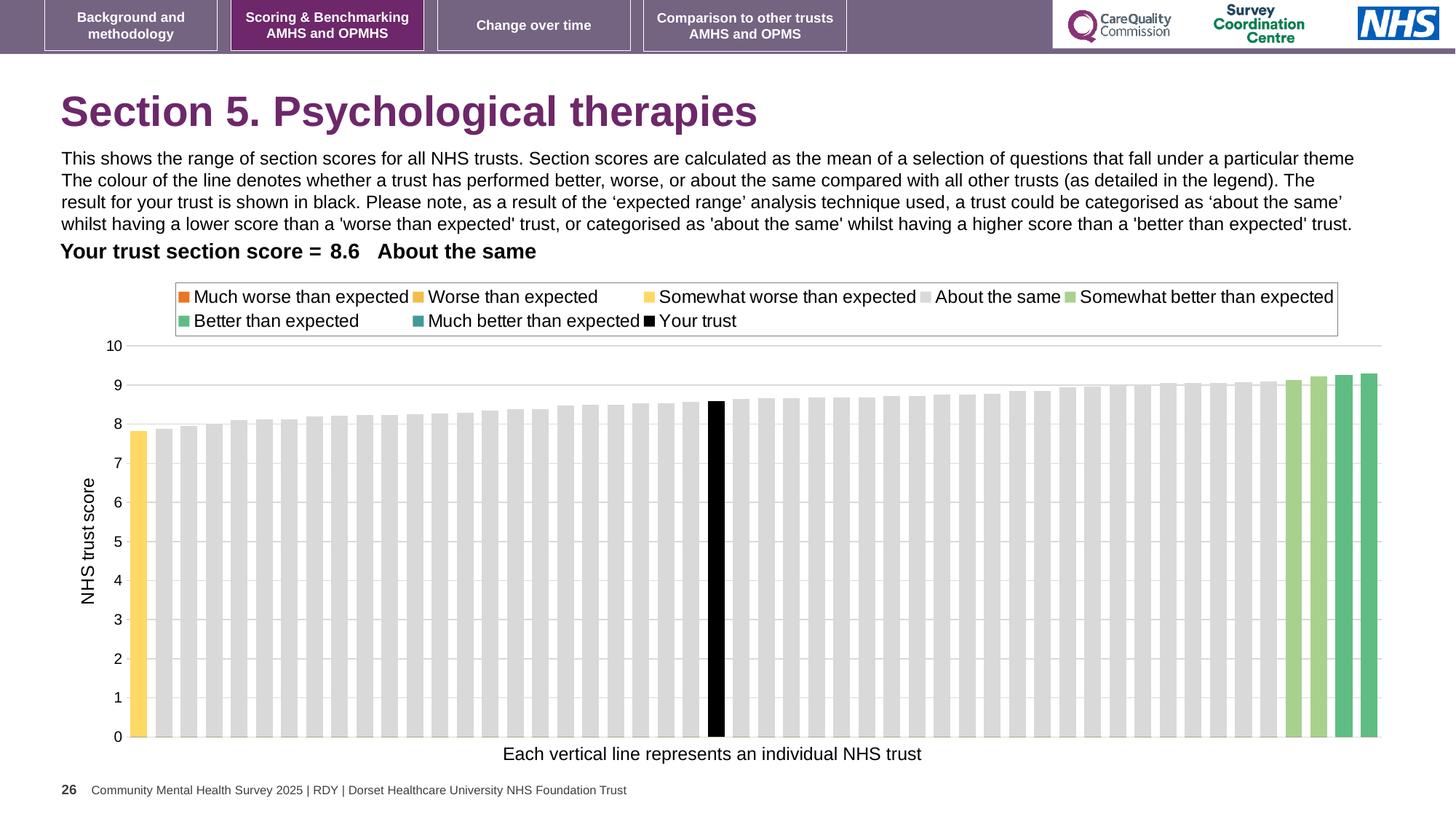
What is the label on the vertical axis of the chart? NHS trust score Is the value of the black bar (your trust) greater or less than 8? greater Do the bar values rise or fall from left to right across the chart? rise How many entries does the chart legend list? 8 Is the value of the tallest bar on the right greater or less than 9? greater Which benchmarking category is your trust placed in for this section? About the same Which legend category does the tallest bar (rightmost, dark green) belong to? Better than expected What is the section score for your trust shown on the slide? 8.6 What colour is the bar representing your trust? black What kind of chart is shown on the slide? bar chart What is the highest value shown on the vertical axis? 10 Is the value of the leftmost (yellow) bar greater or less than 7? greater